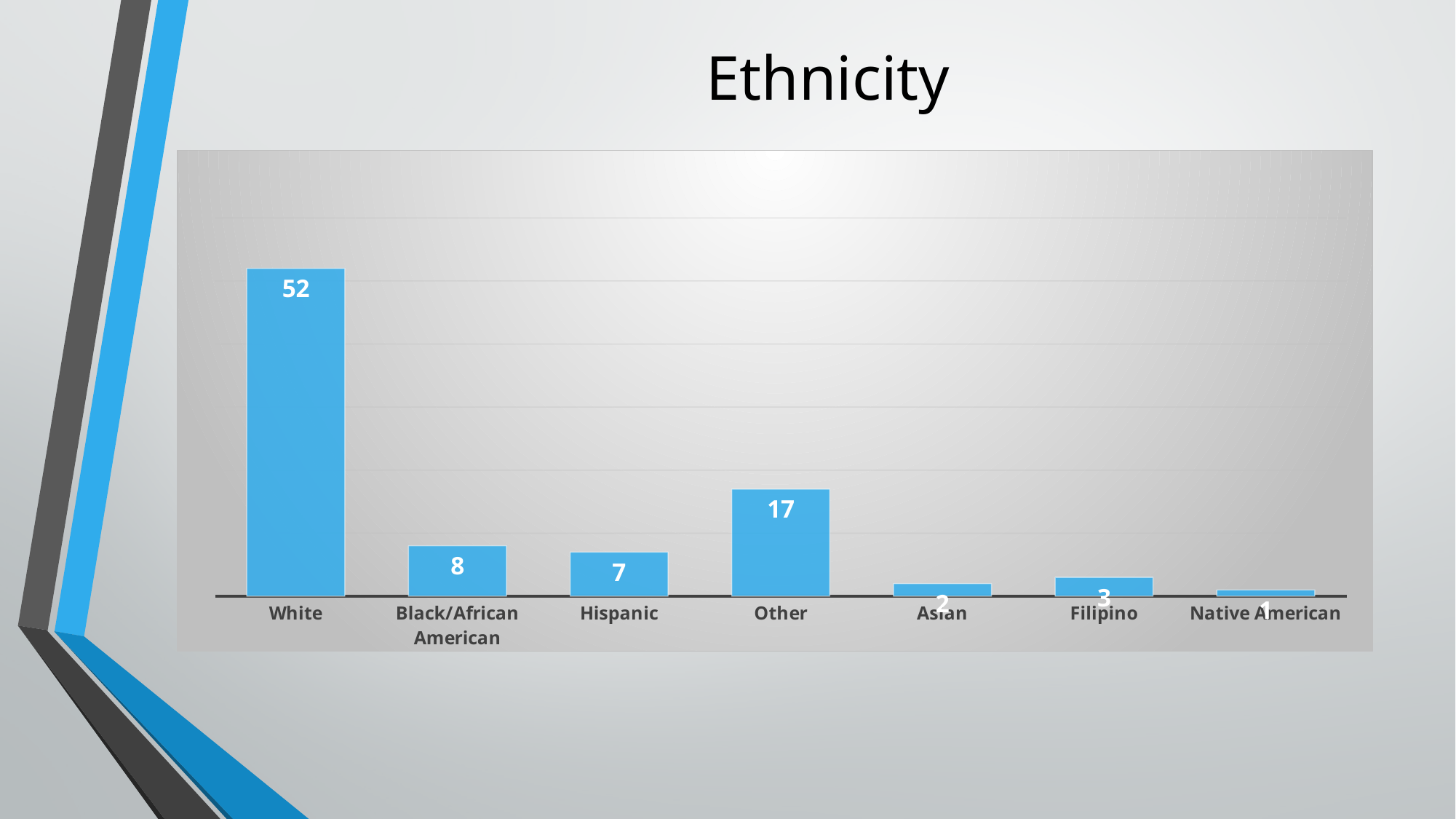
What is the value for Other? 17 Which category has the highest value? White Which category has the lowest value? Native American Which is larger, the value for Other or the value for Black/African American? Other How many categories are shown on the x axis? 7 What is the value for Hispanic? 7 What is the value for Black/African American? 8 What is the difference between the values for Black/African American and Hispanic? 1 What kind of chart is shown on the slide? Bar chart What is the difference between the values for White and Other? 35 What is the value for White? 52 What is the value for Filipino? 3